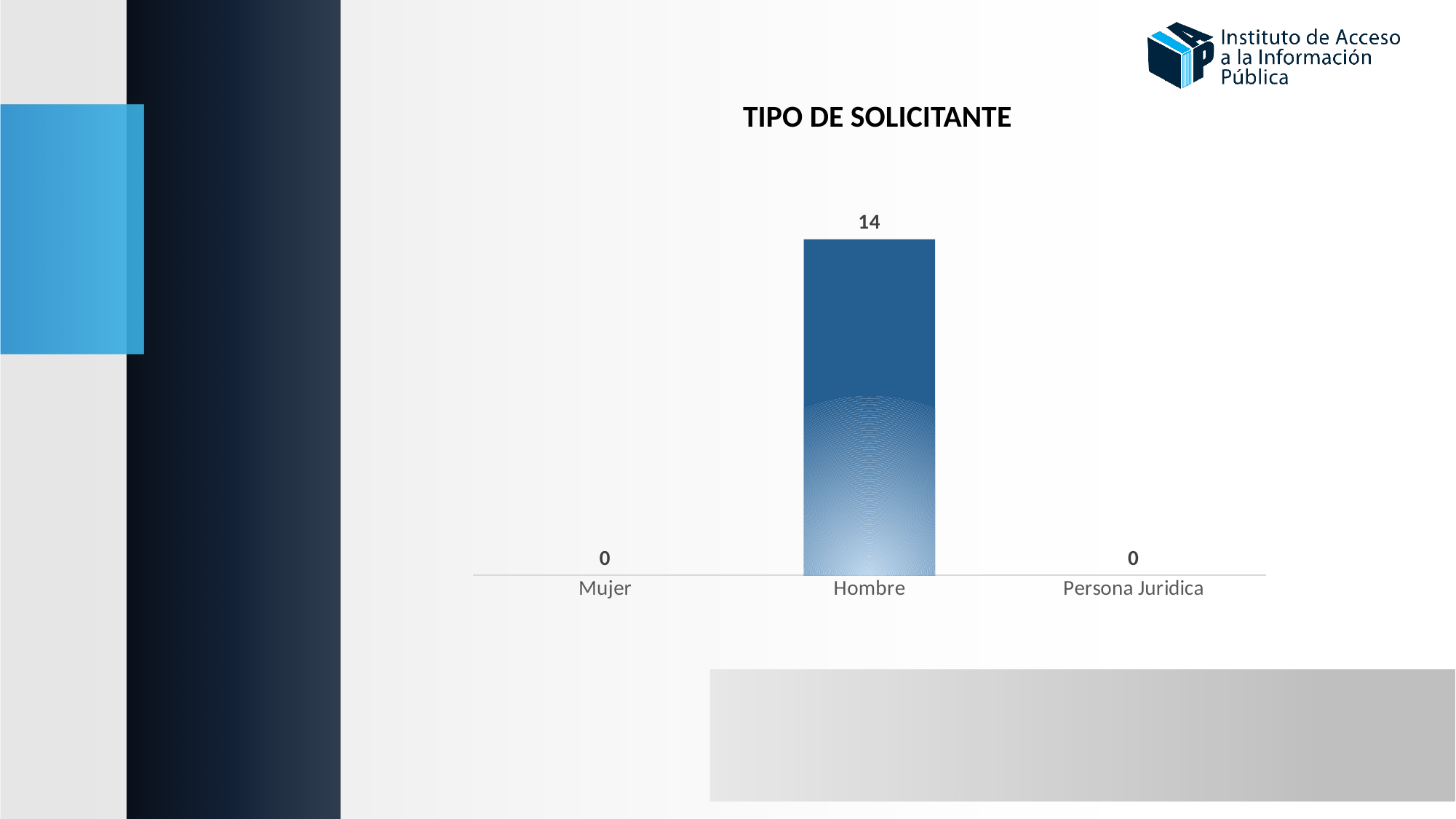
What is the total of the values across all three categories? 14 Which category has the highest value? Hombre How many categories have a value of 0? 2 What is the difference between the values for Hombre and Mujer? 14 What is the title of the chart? TIPO DE SOLICITANTE How many categories are shown on the x axis? 3 What is the value for Mujer? 0 What kind of chart is shown on the slide? Bar chart Which is larger, the value for Hombre or the value for Persona Juridica? Hombre What is the value for Persona Juridica? 0 What is the value for Hombre? 14